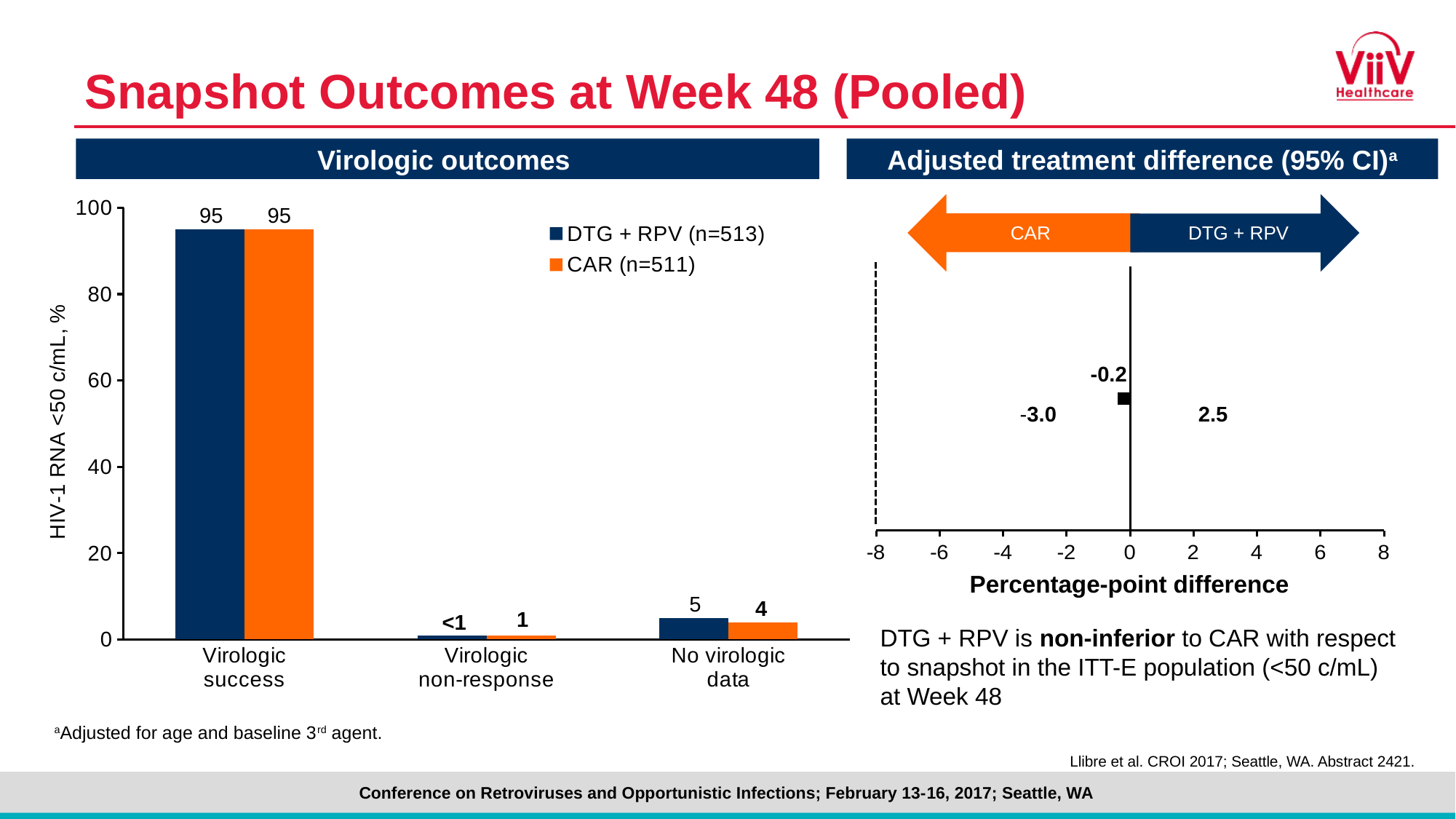
In the Adjusted treatment difference chart, what is the point estimate of the percentage-point difference? -0.2 In the Virologic outcomes chart, what is the value for DTG + RPV in the Virologic non-response category? <1 In the Virologic outcomes chart, how many categories are shown on the x axis? 3 In the Virologic outcomes chart, which series has the larger value in the No virologic data category? DTG + RPV In the Virologic outcomes chart, what is the value for CAR in the Virologic non-response category? 1 In the Virologic outcomes chart, what is the value for DTG + RPV in the Virologic success category? 95 In the Virologic outcomes chart, which category has the highest value for CAR? Virologic success In the Virologic outcomes chart, how many series does the legend list? 2 What kind of chart is the Virologic outcomes chart? Bar chart In the Adjusted treatment difference chart, what are the lower and upper bounds of the 95% CI? -3.0 and 2.5 In the Virologic outcomes chart, what is the value for CAR in the No virologic data category? 4 In the Virologic outcomes chart, what is the difference between DTG + RPV and CAR in the No virologic data category? 1